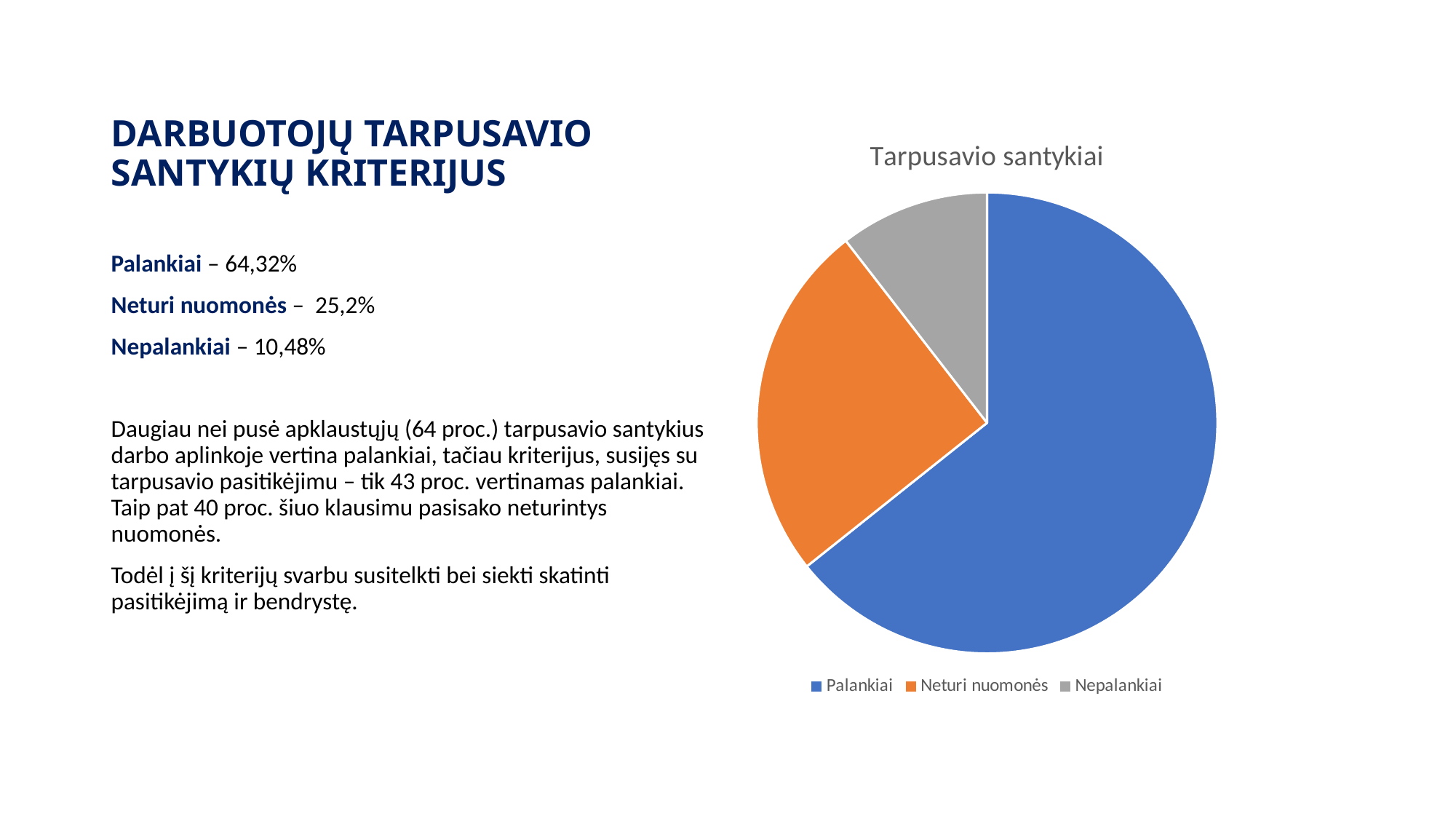
What is the share for Neturi nuomonės? 25,2% How many categories does the legend of the pie chart list? 3 Which colour represents Neturi nuomonės in the pie chart? orange What is the share for Palankiai? 64,32% What is the title of the chart? Tarpusavio santykiai What is the difference between the shares for Palankiai and Neturi nuomonės? 39,12% Which category has the largest slice of the pie chart? Palankiai What kind of chart is shown on the slide? pie chart Which is larger, the slice for Neturi nuomonės or the slice for Nepalankiai? Neturi nuomonės Which category has the smallest slice of the pie chart? Nepalankiai What is the share for Nepalankiai? 10,48% Is the slice for Palankiai more or less than half of the pie? more